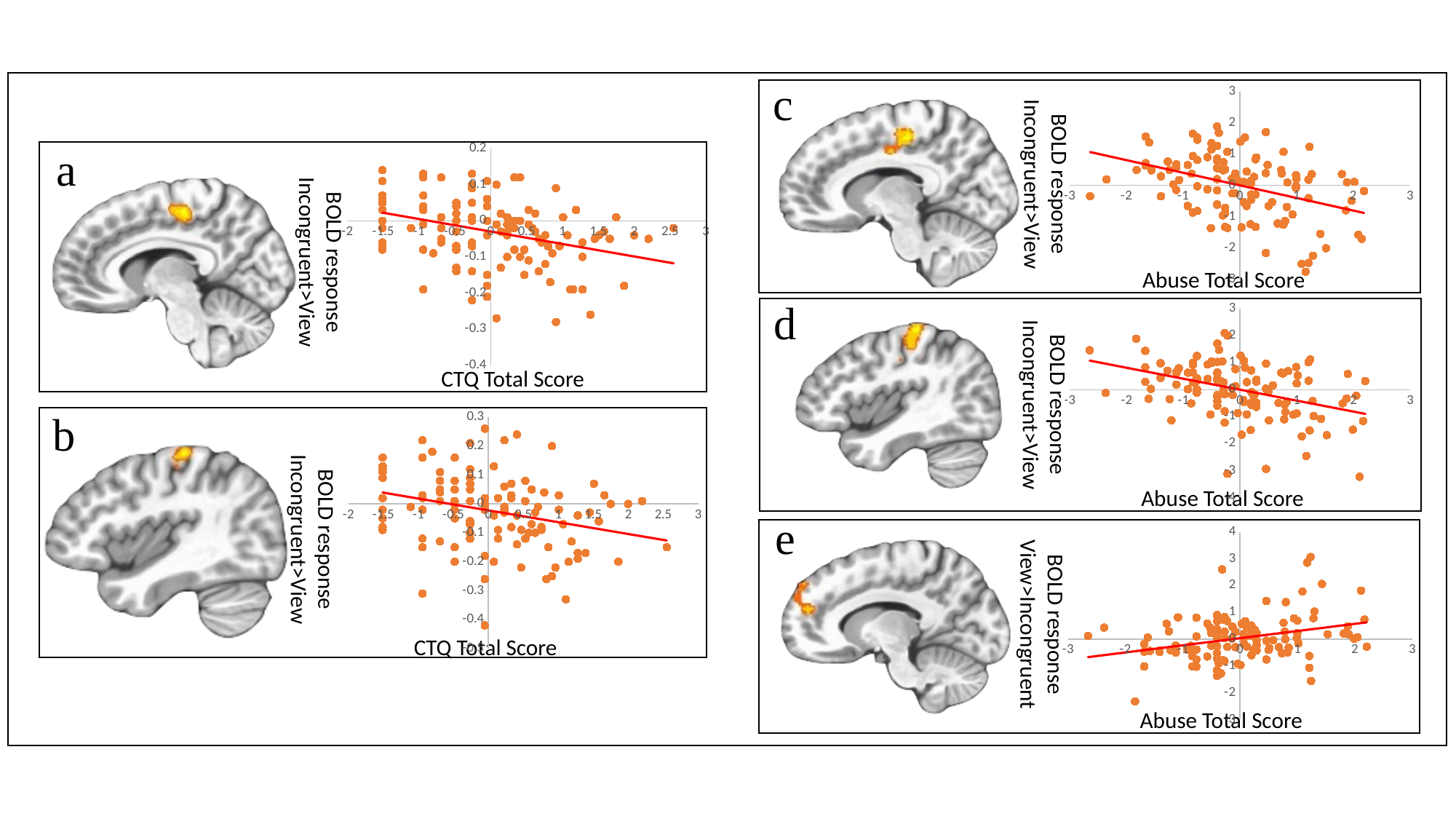
In panel e, does the red trend line rise or fall as Abuse Total Score increases? rise In panel a, what is the highest value shown on the y-axis? 0.2 In panel a, does the red trend line rise or fall as CTQ Total Score increases? fall In panel b, what is the lowest value shown on the y-axis? -0.5 What kind of chart is shown in panel a? scatter plot In panel b, does the red trend line rise or fall as CTQ Total Score increases? fall How many scatter plots are shown on the slide? 5 What is the y-axis label of the scatter plot in panel e? BOLD response View>Incongruent In panel e, what is the highest value shown on the y-axis? 4 What is the x-axis label of the scatter plot in panel a? CTQ Total Score